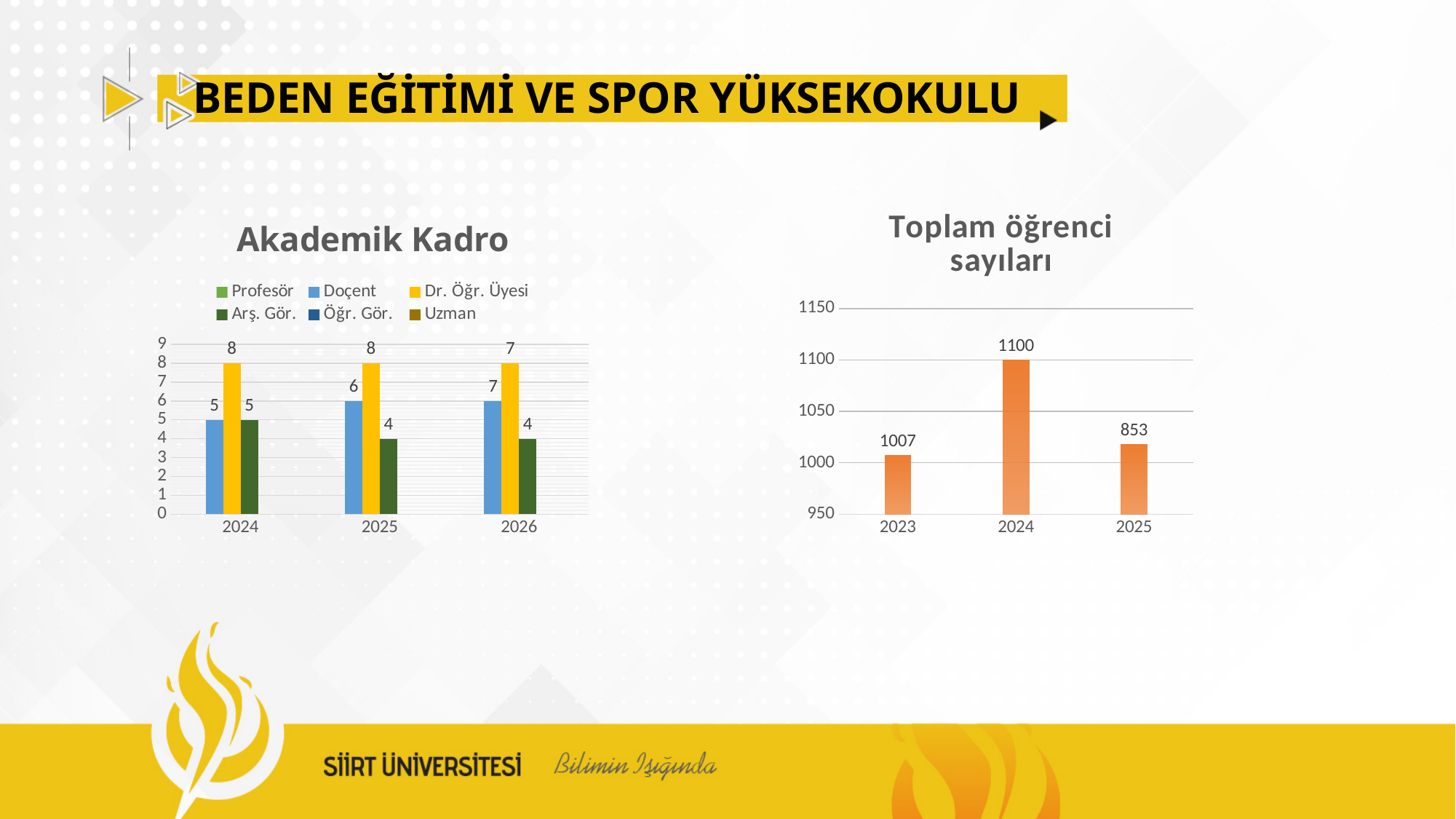
In the 'Akademik Kadro' chart, what is the value for Doçent in 2025? 6 What kind of chart is the 'Akademik Kadro' chart? Bar chart In the 'Akademik Kadro' chart, what is the difference between Dr. Öğr. Üyesi and Arş. Gör. in 2025? 4 How many year categories are shown on the x axis of the 'Akademik Kadro' chart? 3 In the 'Akademik Kadro' chart, which is larger in 2024: Doçent or Dr. Öğr. Üyesi? Dr. Öğr. Üyesi In the 'Toplam öğrenci sayıları' chart, what is the difference between the 2024 and 2023 values? 93 In the 'Akademik Kadro' chart, what is the value for Dr. Öğr. Üyesi in 2024? 8 In the 'Toplam öğrenci sayıları' chart, what is the value for 2023? 1007 In the 'Toplam öğrenci sayıları' chart, what is the value for 2024? 1100 How many series does the legend of the 'Akademik Kadro' chart list? 6 In the 'Akademik Kadro' chart, what is the value for Arş. Gör. in 2026? 4 In the 'Toplam öğrenci sayıları' chart, which year has the highest value? 2024